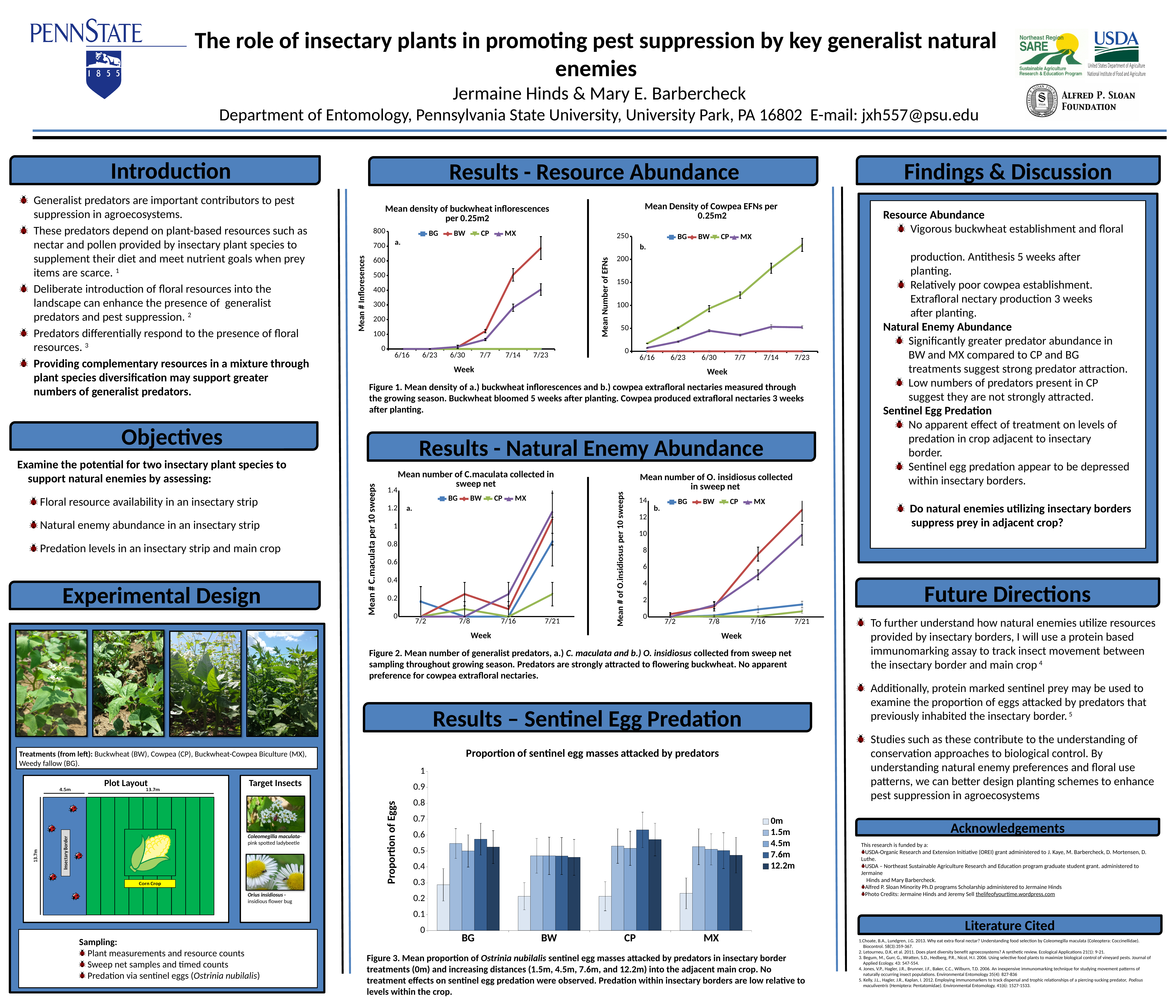
In the 'Mean density of buckwheat inflorescences per 0.25m2' chart, which treatment has the highest value on 7/23? BW In the 'Mean Density of Cowpea EFNs per 0.25m2' chart, which treatment has the highest value on 7/23? CP In the 'Mean number of O. insidiosus collected in sweep net' chart, do the BW values rise or fall from 7/2 to 7/21? rise What kind of chart is the 'Mean density of buckwheat inflorescences per 0.25m2' chart? line chart In the 'Proportion of sentinel egg masses attacked by predators' chart, which distance has the lowest proportion for BW? 0m How many series does the legend of the 'Proportion of sentinel egg masses attacked by predators' chart list? 5 What kind of chart is the 'Proportion of sentinel egg masses attacked by predators' chart? bar chart In the 'Mean density of buckwheat inflorescences per 0.25m2' chart, is the BW value on 7/23 greater or less than 600? greater In the 'Mean number of O. insidiosus collected in sweep net' chart, which is larger on 7/21, BW or CP? BW How many treatment categories are shown on the x axis of the 'Proportion of sentinel egg masses attacked by predators' chart? 4 In the 'Proportion of sentinel egg masses attacked by predators' chart, is the 0m value for BG greater or less than 0.5? less In the 'Mean Density of Cowpea EFNs per 0.25m2' chart, is the CP value on 7/23 greater or less than 200? greater